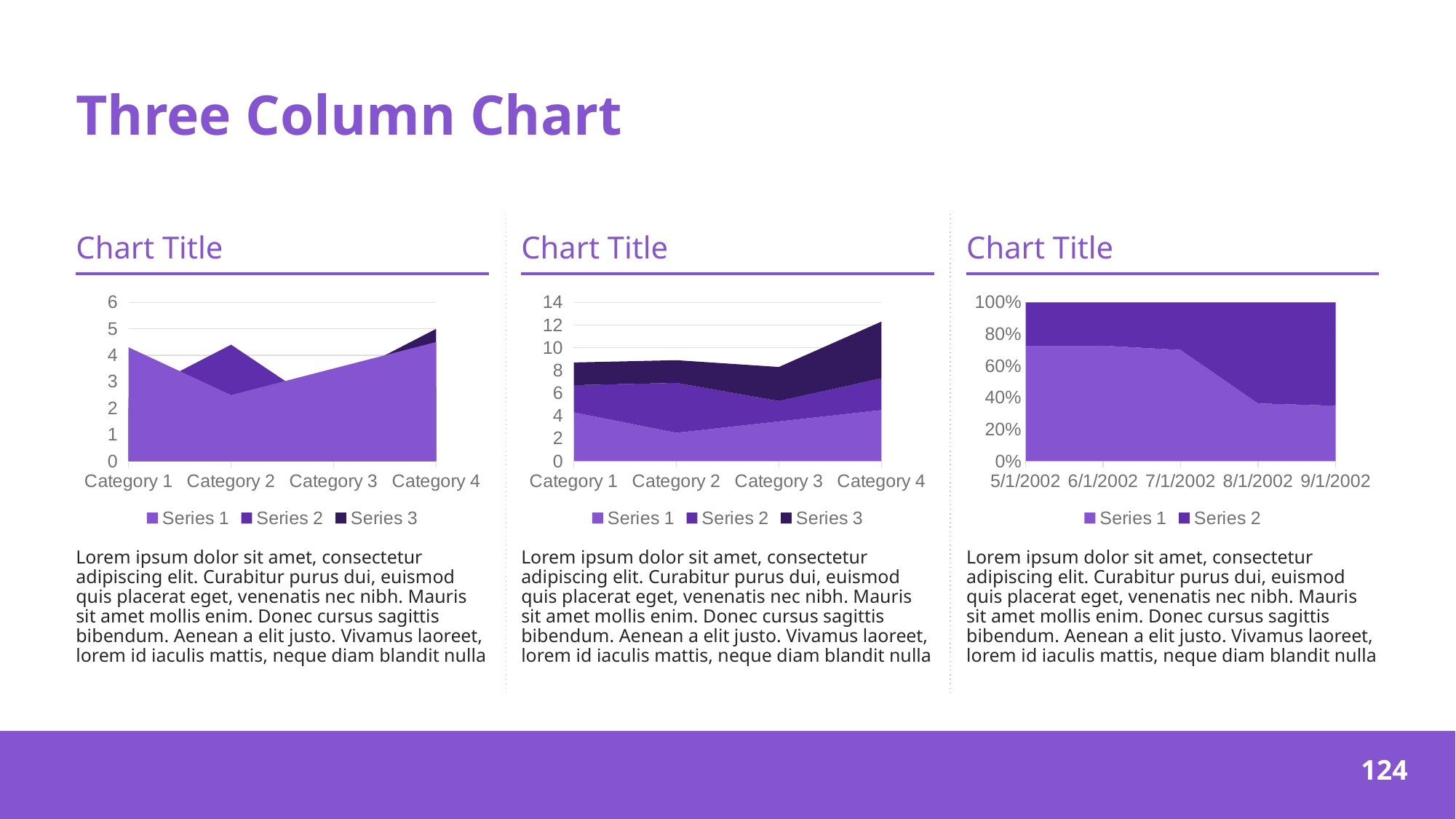
How many series does the legend of the right chart list? 2 How many series does the legend of the left chart list? 3 In the middle chart, is the top of the stacked area at Category 4 greater or less than 10? greater How many categories does the left chart show on its x axis? 4 How many dates does the right chart show on its x axis? 5 In the left chart, is the value of Series 1 for Category 2 greater or less than 3? less What is the title shown above the right chart? Chart Title What kind of chart is the left chart on the slide? area chart In the left chart, is the value of Series 2 for Category 2 greater or less than 4? greater In the right chart, does the share of Series 1 rise or fall from 5/1/2002 to 9/1/2002? fall How many categories does the middle chart show on its x axis? 4